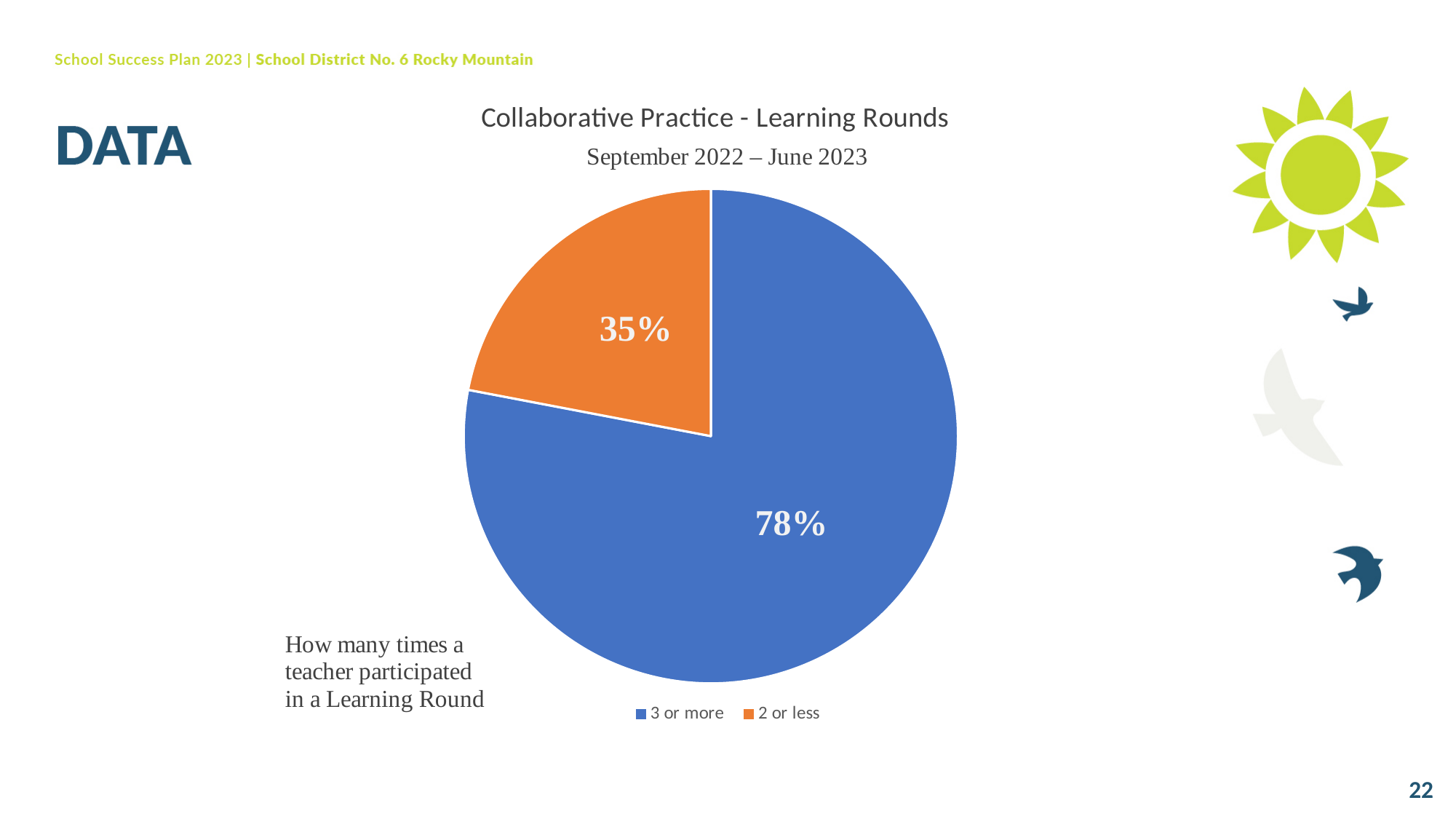
What kind of chart is shown on the slide? Pie chart How many entries does the legend list? 2 Which is larger, the "3 or more" slice or the "2 or less" slice? 3 or more What is the difference in percentage points between the "3 or more" slice and the "2 or less" slice? 43 percentage points Which category has the largest slice of the pie? 3 or more What percentage is shown for the "3 or more" slice? 78% What percentage is shown for the "2 or less" slice? 35% What share of the pie does the "3 or more" slice represent according to its label? 78% What is the title of the chart? Collaborative Practice - Learning Rounds How many slices does the pie chart have? 2 Which category has the smallest slice of the pie? 2 or less What colour is the "2 or less" slice? Orange